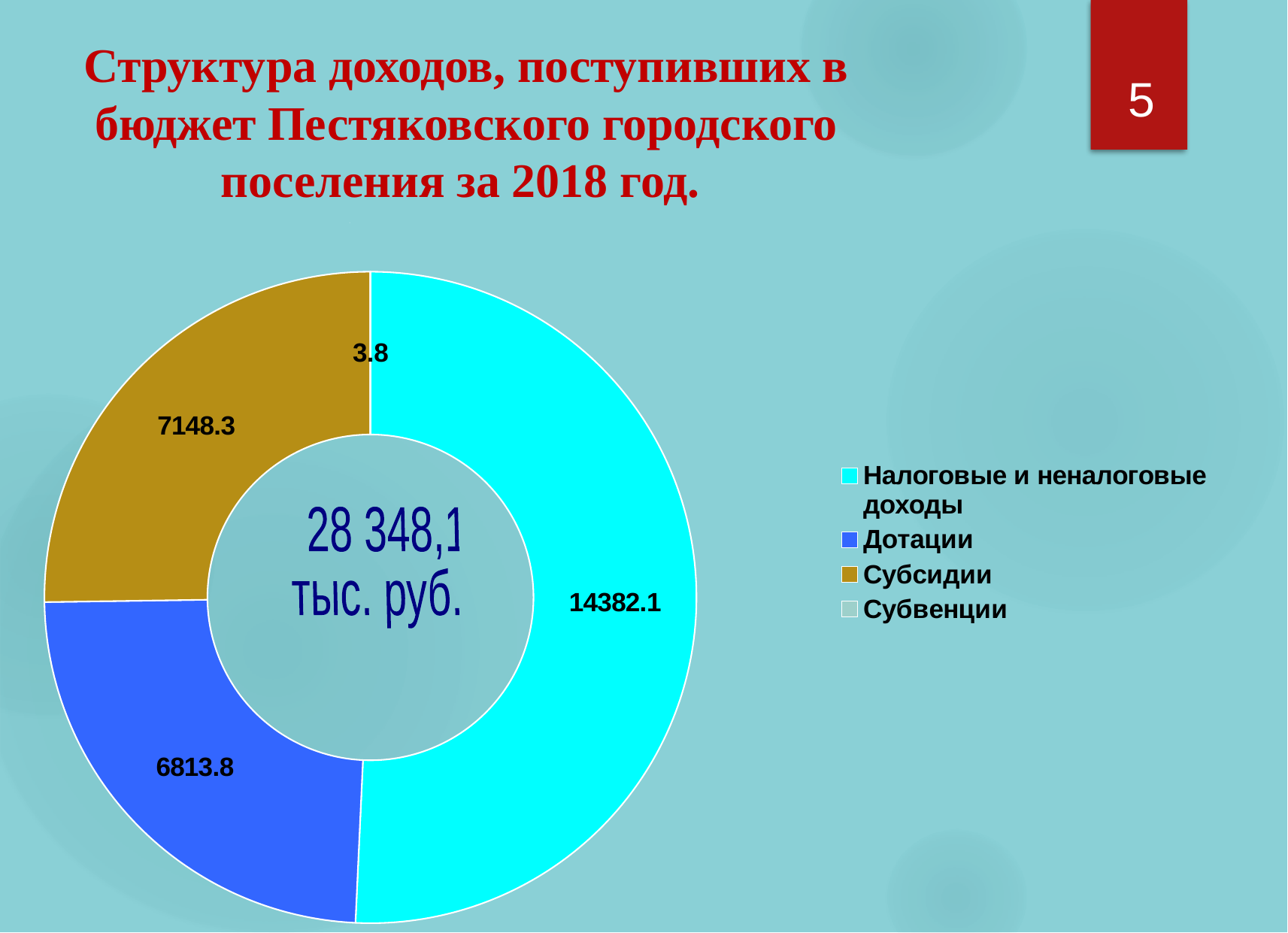
Which is larger, Субсидии or Дотации? Субсидии What is the value for Субсидии? 7148.3 What total is printed in the centre of the chart? 28 348,1 тыс. руб. What is the value for Субвенции? 3.8 Which category has the smallest value? Субвенции What is the value for Налоговые и неналоговые доходы? 14382.1 What is the difference between Налоговые и неналоговые доходы and Субсидии? 7233.8 What kind of chart is shown on the slide? Doughnut chart How many categories does the chart show? 4 Which category has the largest value? Налоговые и неналоговые доходы What is the difference between Субсидии and Дотации? 334.5 What is the value for Дотации? 6813.8